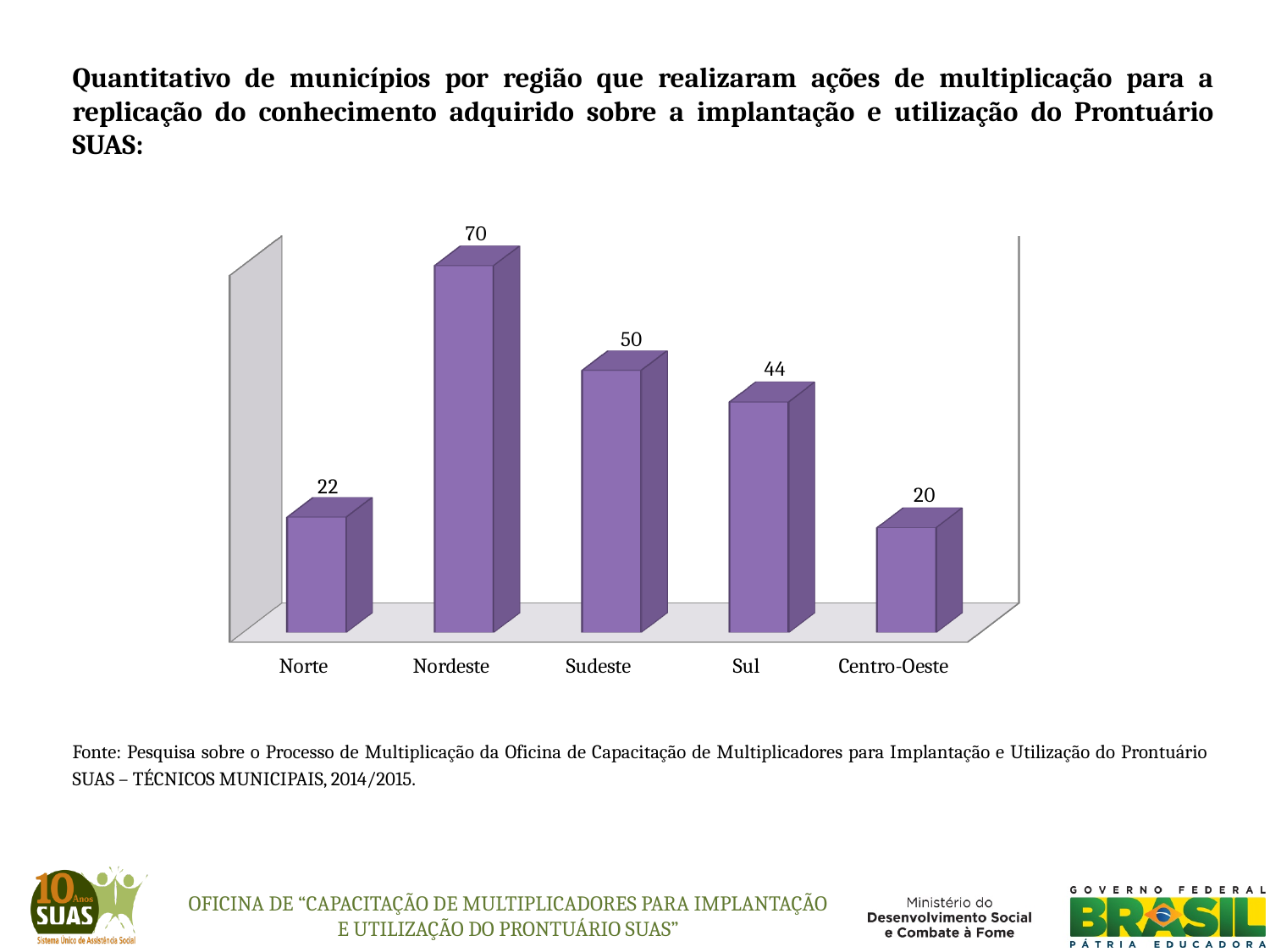
What is the difference between the values for Nordeste and Sudeste? 20 What is the value for Norte? 22 What is the value for Sul? 44 What is the value for Centro-Oeste? 20 Which is larger, the value for Sudeste or the value for Sul? Sudeste Which region has the lowest value? Centro-Oeste How many regions are shown on the chart? 5 What colour are the bars in the chart? Purple What is the value for Nordeste? 70 What is the difference between the values for Sul and Centro-Oeste? 24 What kind of chart is shown on the slide? Bar chart Which region has the highest value? Nordeste